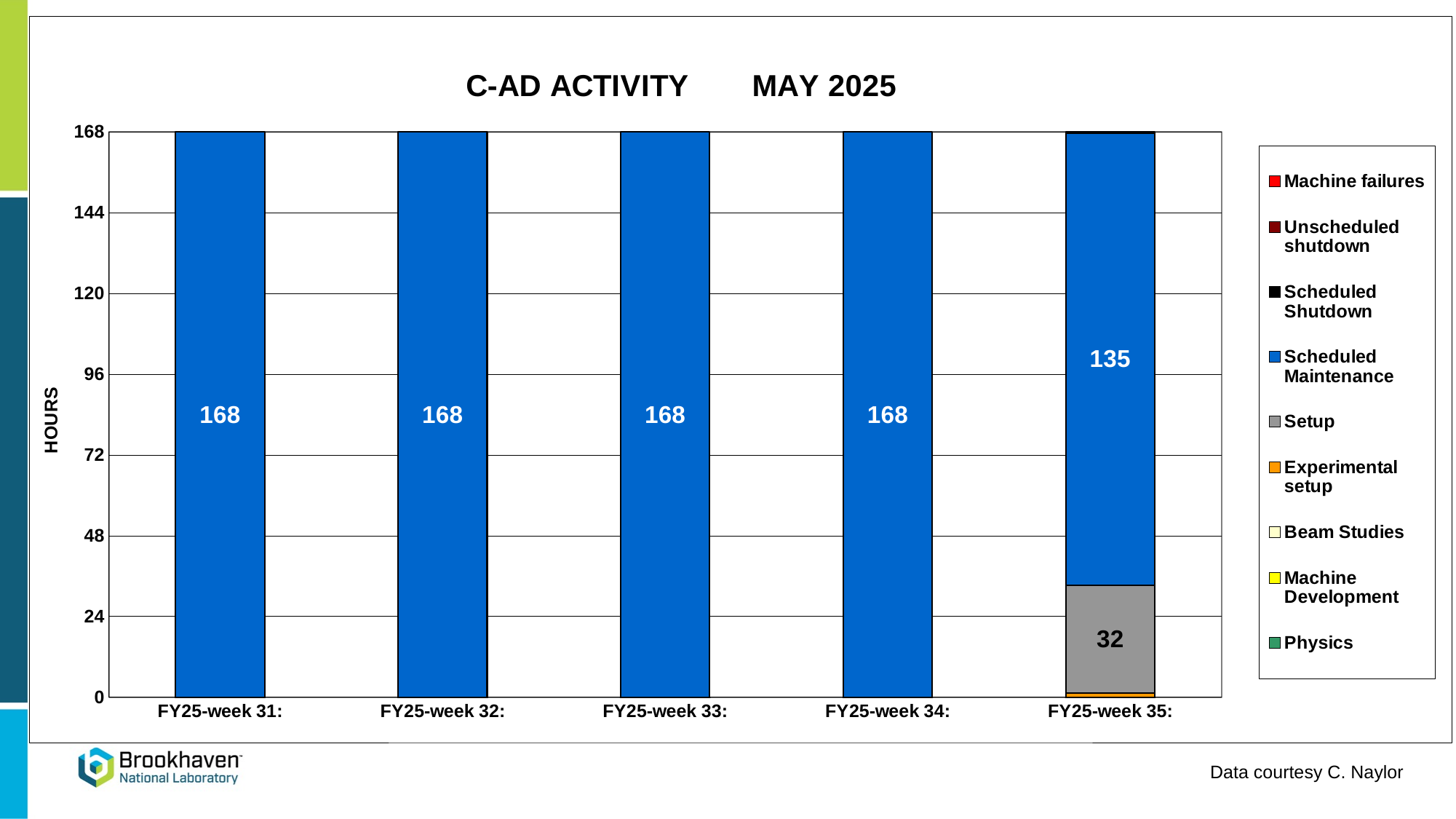
In FY25-week 35, which is larger: Scheduled Maintenance or Setup? Scheduled Maintenance What is the label on the y axis? HOURS Which week has the lowest Scheduled Maintenance value? FY25-week 35 What is the Scheduled Maintenance value for FY25-week 31? 168 What kind of chart is shown? stacked bar chart Is the Scheduled Maintenance value for FY25-week 35 greater or less than 120? greater What is the difference between the Scheduled Maintenance values for FY25-week 34 and FY25-week 35? 33 How many series does the legend list? 9 How many weeks are shown on the x axis? 5 In FY25-week 35, what is the difference between the Scheduled Maintenance value and the Setup value? 103 What is the Scheduled Maintenance value for FY25-week 35? 135 What is the Setup value for FY25-week 35? 32